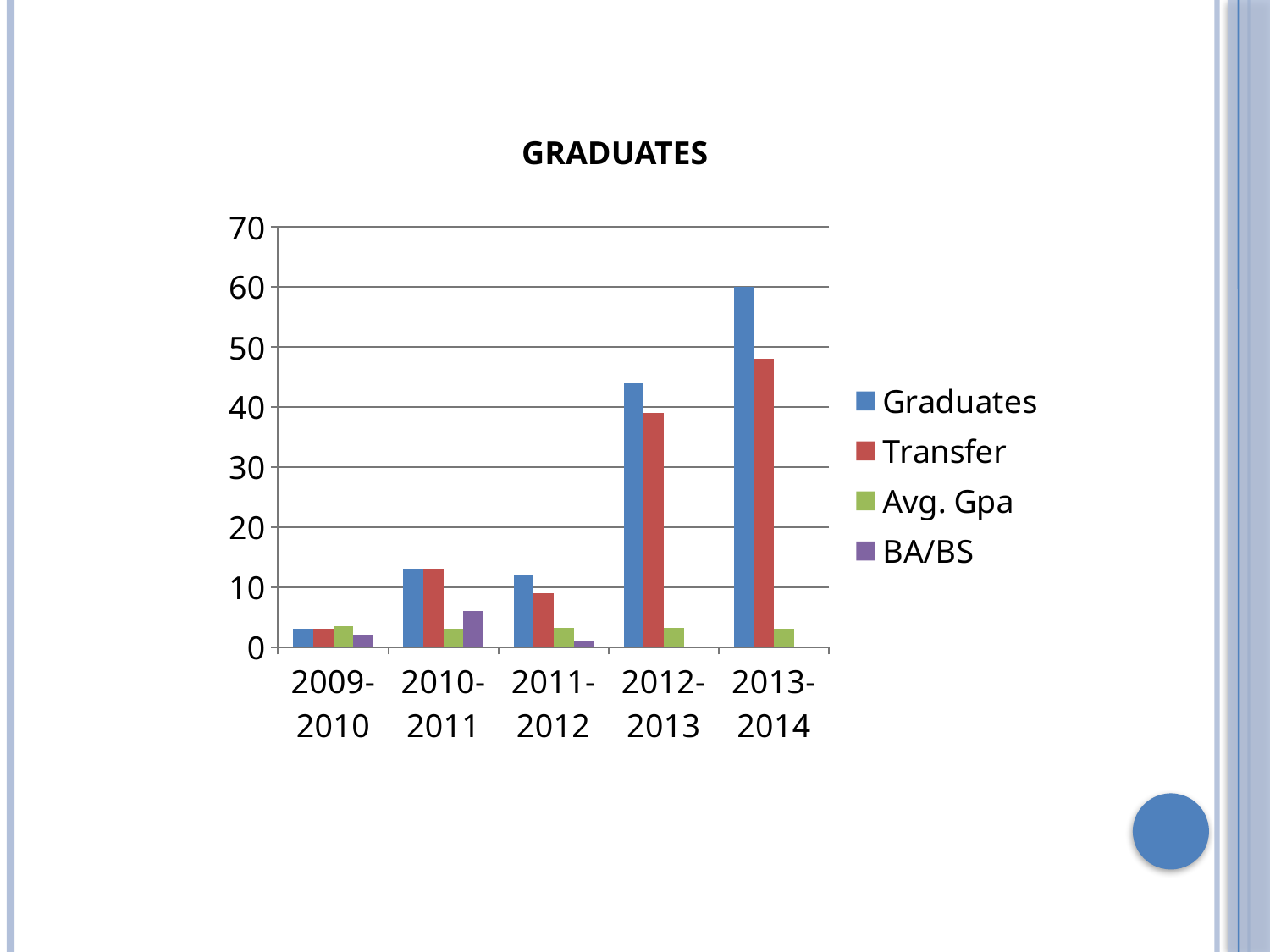
Which academic year has the lowest Graduates value? 2009-2010 Is the Graduates value for 2012-2013 greater or less than 40? greater Is the Transfer value for 2013-2014 greater or less than 50? less How many series does the legend list? 4 How many academic-year categories are shown on the x axis? 5 What colour are the Transfer bars? red What kind of chart is shown on the slide? bar chart Do the Graduates values rise or fall from 2011-2012 to 2013-2014? rise In 2012-2013, which is larger, Graduates or Transfer? Graduates What is the title of the chart? GRADUATES Is the Transfer value for 2012-2013 greater or less than 30? greater Which academic year has the highest Graduates value? 2013-2014